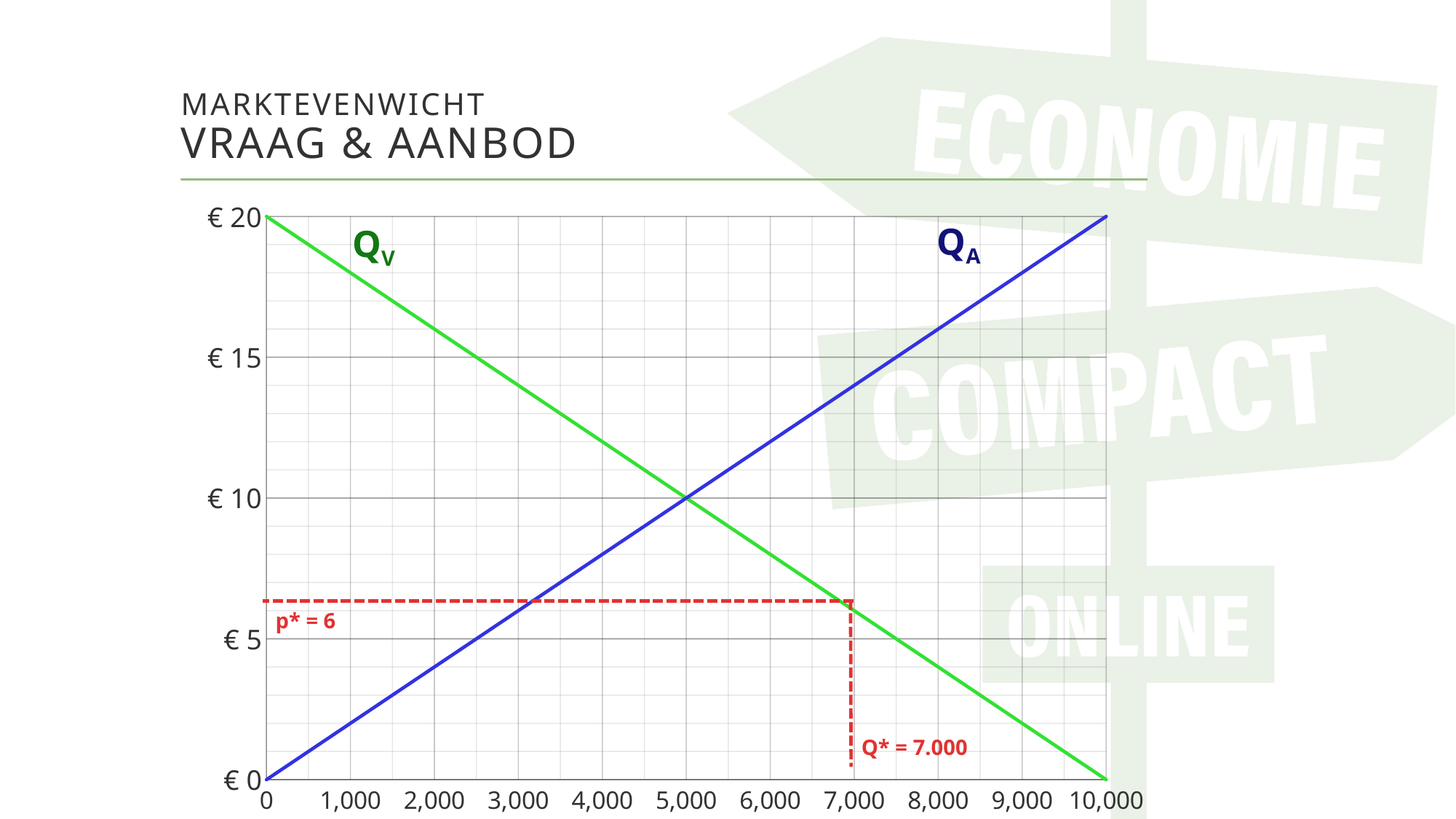
Does the Q_V line rise or fall as quantity increases along the x axis? fall What is the price on the Q_V line at a quantity of 0? € 20 Does the Q_A line rise or fall as quantity increases along the x axis? rise What value is given for Q* in the red annotation on the chart? 7.000 What is the price on the Q_A line at a quantity of 0? € 0 What is the price on the Q_A line at a quantity of 10,000? € 20 What kind of chart is shown on the slide? line chart Is the price on the Q_A line at a quantity of 2,000 greater or less than € 5? less At what price do the Q_V and Q_A lines intersect? € 10 How many lines are plotted on the chart? 2 At what quantity do the Q_V and Q_A lines intersect? 5,000 Is the price on the Q_V line at a quantity of 2,000 greater or less than € 15? greater